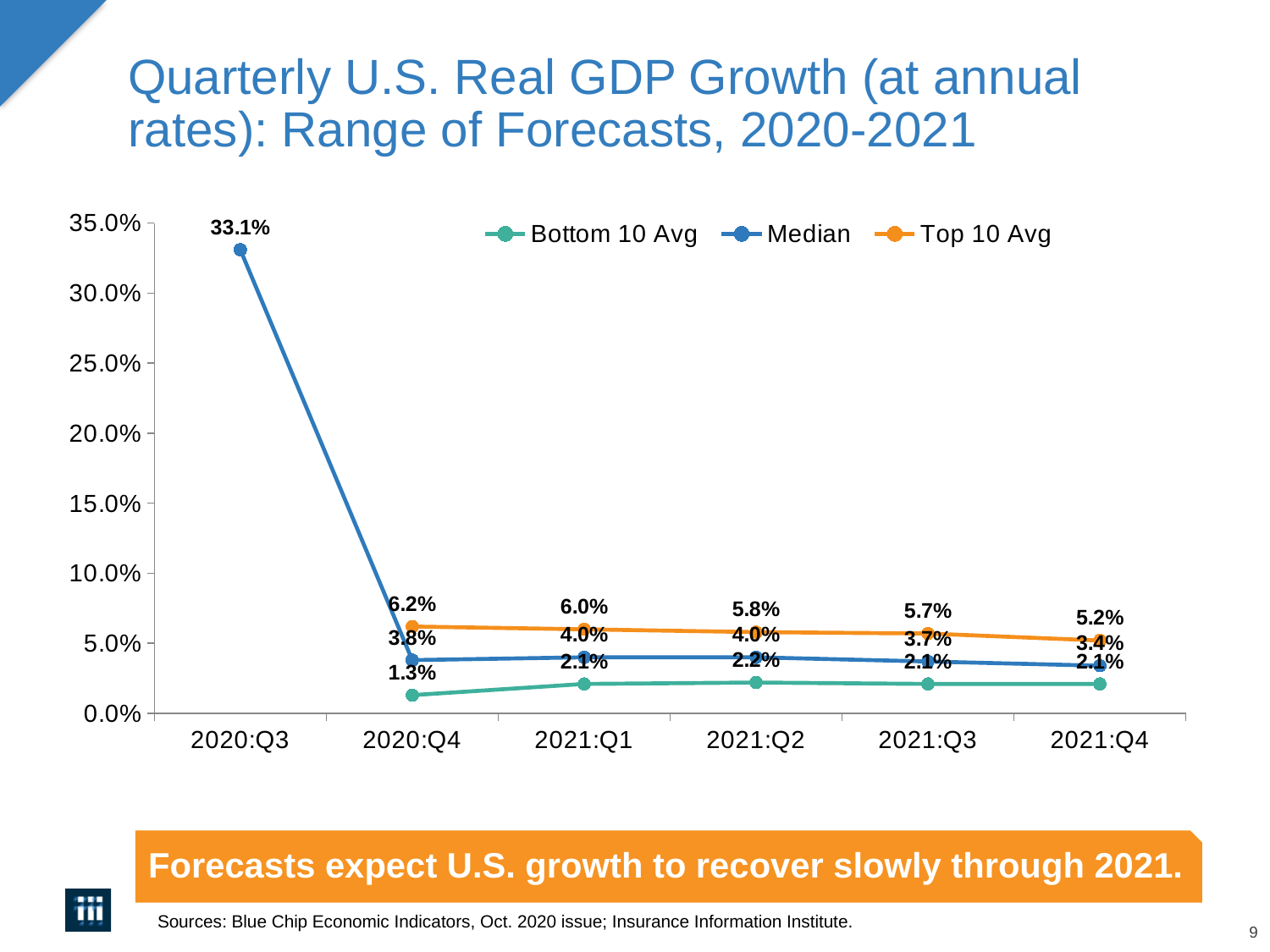
Which quarter has the lowest Top 10 Avg forecast value? 2021:Q4 What is the Median forecast for 2021:Q4? 3.4% What is the Median forecast value for 2020:Q3? 33.1% Is the Median value for 2020:Q3 greater or less than 30.0%? greater What is the difference between the Top 10 Avg and Bottom 10 Avg forecasts for 2021:Q2? 3.6% How many quarters are shown on the x axis? 6 Is the Median forecast for 2021:Q1 larger or smaller than the Median forecast for 2021:Q3? larger What is the Top 10 Avg forecast for 2021:Q1? 6.0% How many series does the legend list? 3 Which quarter has the highest Median forecast value? 2020:Q3 What kind of chart is shown on the slide? line chart What is the Bottom 10 Avg forecast for 2020:Q4? 1.3%